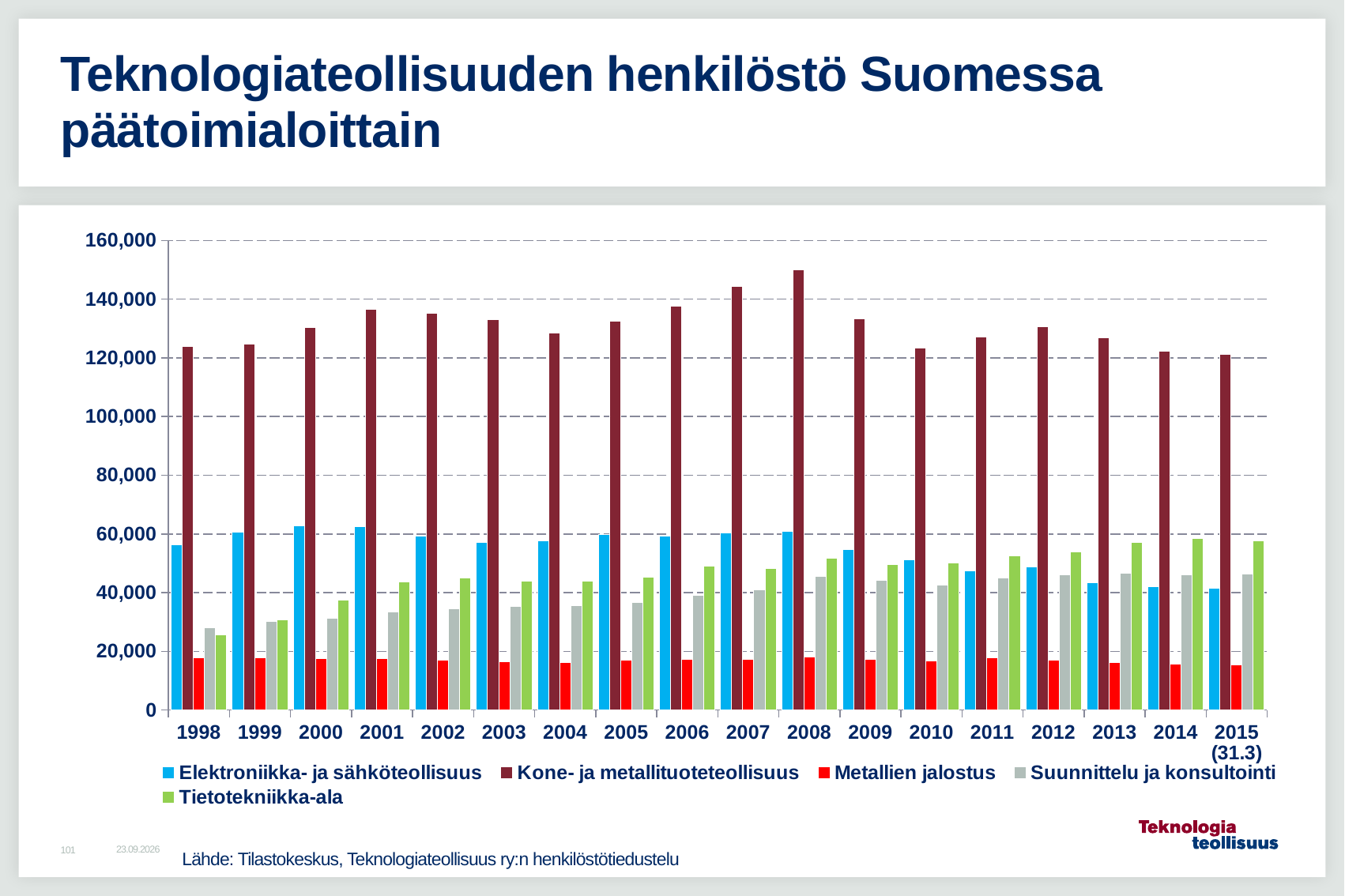
Which series is shown in red in the legend? Metallien jalostus In 2015 (31.3), which is larger: Tietotekniikka-ala or Elektroniikka- ja sähköteollisuus? Tietotekniikka-ala In which year is the value for Tietotekniikka-ala lowest? 1998 Is the value for Elektroniikka- ja sähköteollisuus in 1998 greater or less than 60,000? less In which year is the value for Kone- ja metallituoteteollisuus highest? 2008 Is the value for Kone- ja metallituoteteollisuus in 2008 greater or less than 140,000? greater Is the value for Metallien jalostus in 2008 greater or less than 20,000? less What kind of chart is shown on the slide? bar chart Does the value for Tietotekniikka-ala generally rise or fall from 1998 to 2015? rise How many series does the legend list? 5 How many years are shown on the x axis? 18